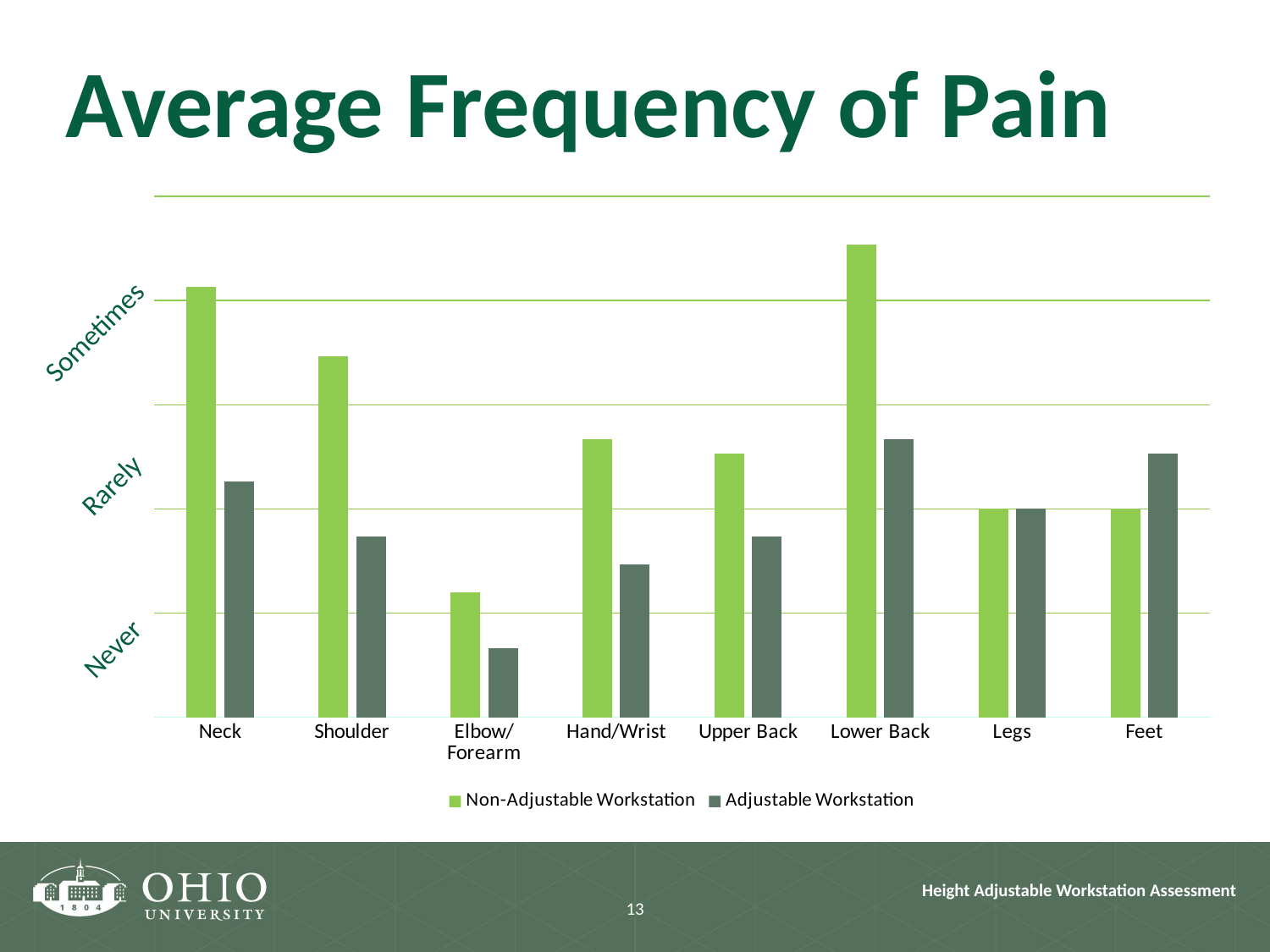
Is the Non-Adjustable Workstation value for Lower Back greater or less than the 'Sometimes' level? greater What frequency level does the Non-Adjustable Workstation bar for Legs reach? Rarely What kind of chart is shown on the slide? bar chart Which category has the lowest Adjustable Workstation bar? Elbow/Forearm For Neck, which is larger: the Non-Adjustable Workstation bar or the Adjustable Workstation bar? Non-Adjustable Workstation For Feet, which is larger: the Non-Adjustable Workstation bar or the Adjustable Workstation bar? Adjustable Workstation What is the title of the chart? Average Frequency of Pain How many series does the legend list? 2 Which category has the lowest Non-Adjustable Workstation bar? Elbow/Forearm How many body-part categories are shown on the x axis? 8 Which category has the highest Non-Adjustable Workstation bar? Lower Back